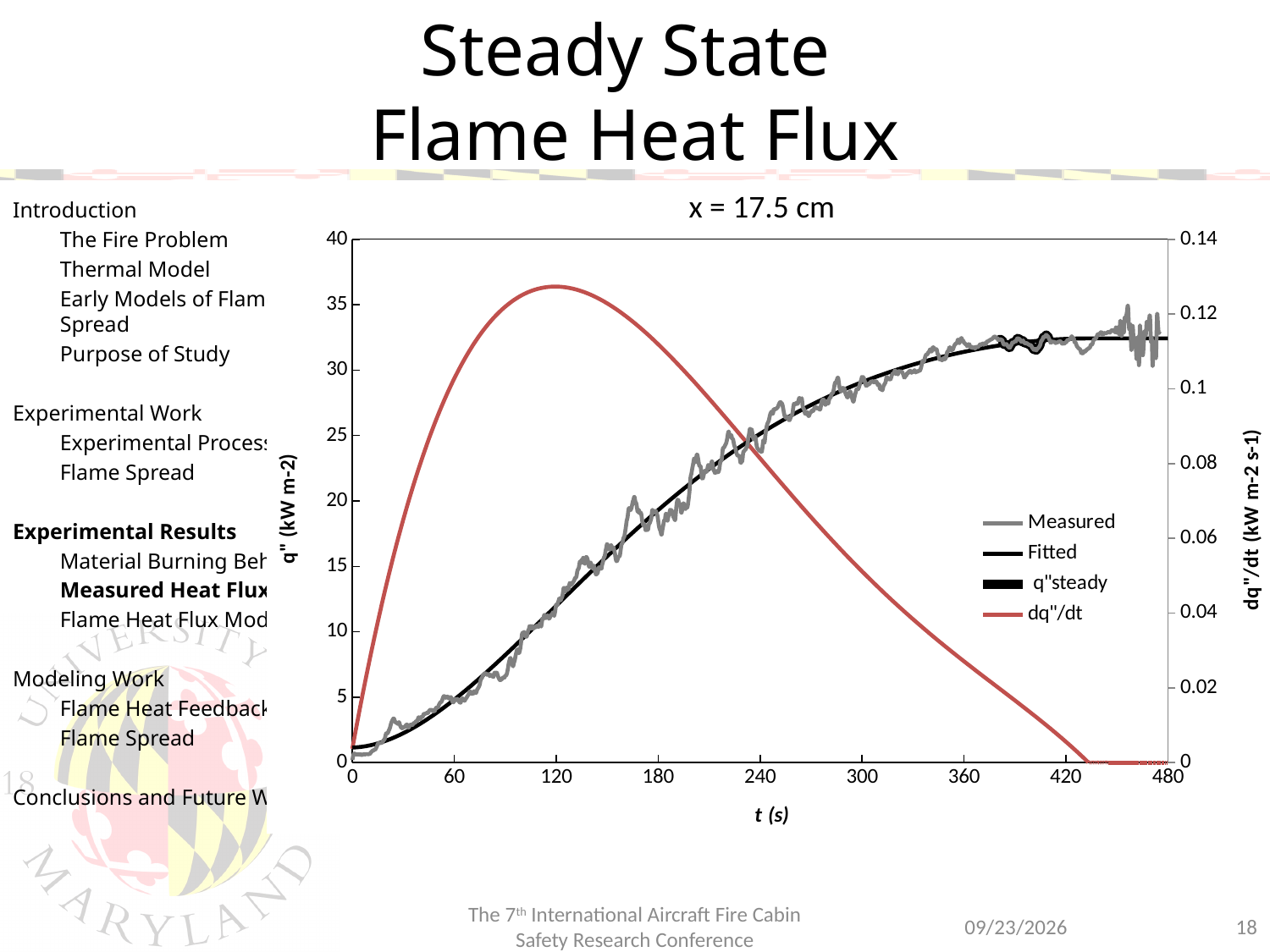
At which t tick on the x axis does the dq"/dt series reach its maximum? 120 Is the Fitted value at t = 120 s greater or less than 10 on the left axis? greater What is the title of the chart? x = 17.5 cm Does the dq"/dt series rise or fall between t = 240 s and t = 420 s? fall How many series does the chart legend list? 4 Is the dq"/dt value at t = 420 s greater or less than 0.02 on the right axis? less Is the peak value of dq"/dt greater or less than 0.12 on the right axis? greater What is the label of the horizontal axis of the chart? t (s) Does the Fitted series rise or fall as t increases from 0 to 480 s? rise What kind of chart is shown on the slide? line chart